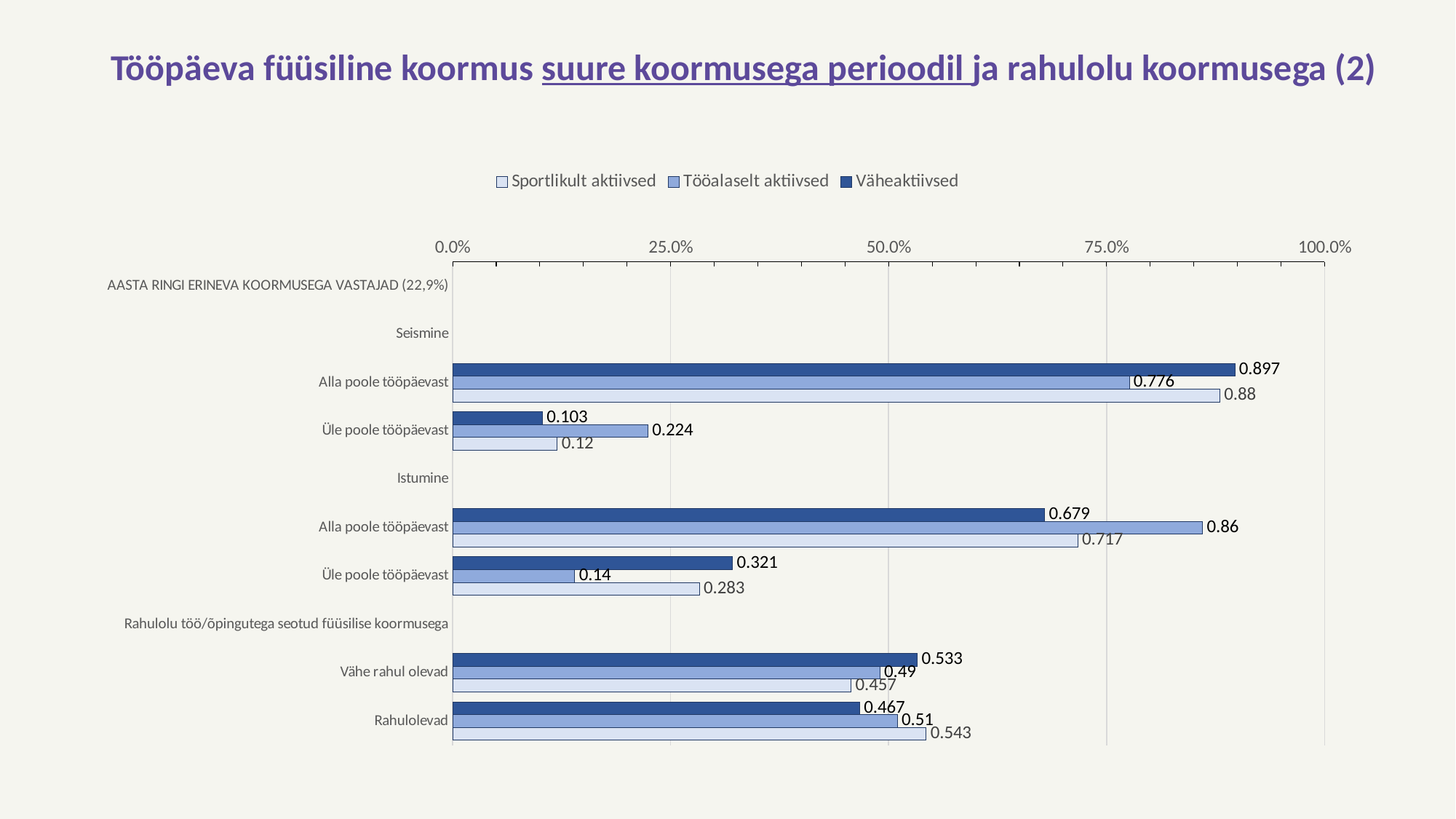
What is the value for Sportlikult aktiivsed for 'Alla poole tööpäevast' under Istumine? 0.717 Which series has the highest value for 'Alla poole tööpäevast' under Istumine? Tööalaselt aktiivsed Is the Väheaktiivsed value for 'Üle poole tööpäevast' under Istumine greater or less than 25.0%? greater What is the value for Sportlikult aktiivsed for 'Rahulolevad'? 0.543 What is the difference between the Väheaktiivsed and Tööalaselt aktiivsed values for 'Alla poole tööpäevast' under Seismine? 0.121 Which is larger for 'Vähe rahul olevad': the Väheaktiivsed value or the Sportlikult aktiivsed value? Väheaktiivsed Which series has the lowest value for 'Üle poole tööpäevast' under Seismine? Väheaktiivsed What is the value for Tööalaselt aktiivsed for 'Üle poole tööpäevast' under Seismine? 0.224 Which series is shown in the darkest blue in the legend? Väheaktiivsed What is the value for Väheaktiivsed for 'Alla poole tööpäevast' under Seismine? 0.897 How many series does the legend list? 3 What kind of chart is shown on the slide? Bar chart